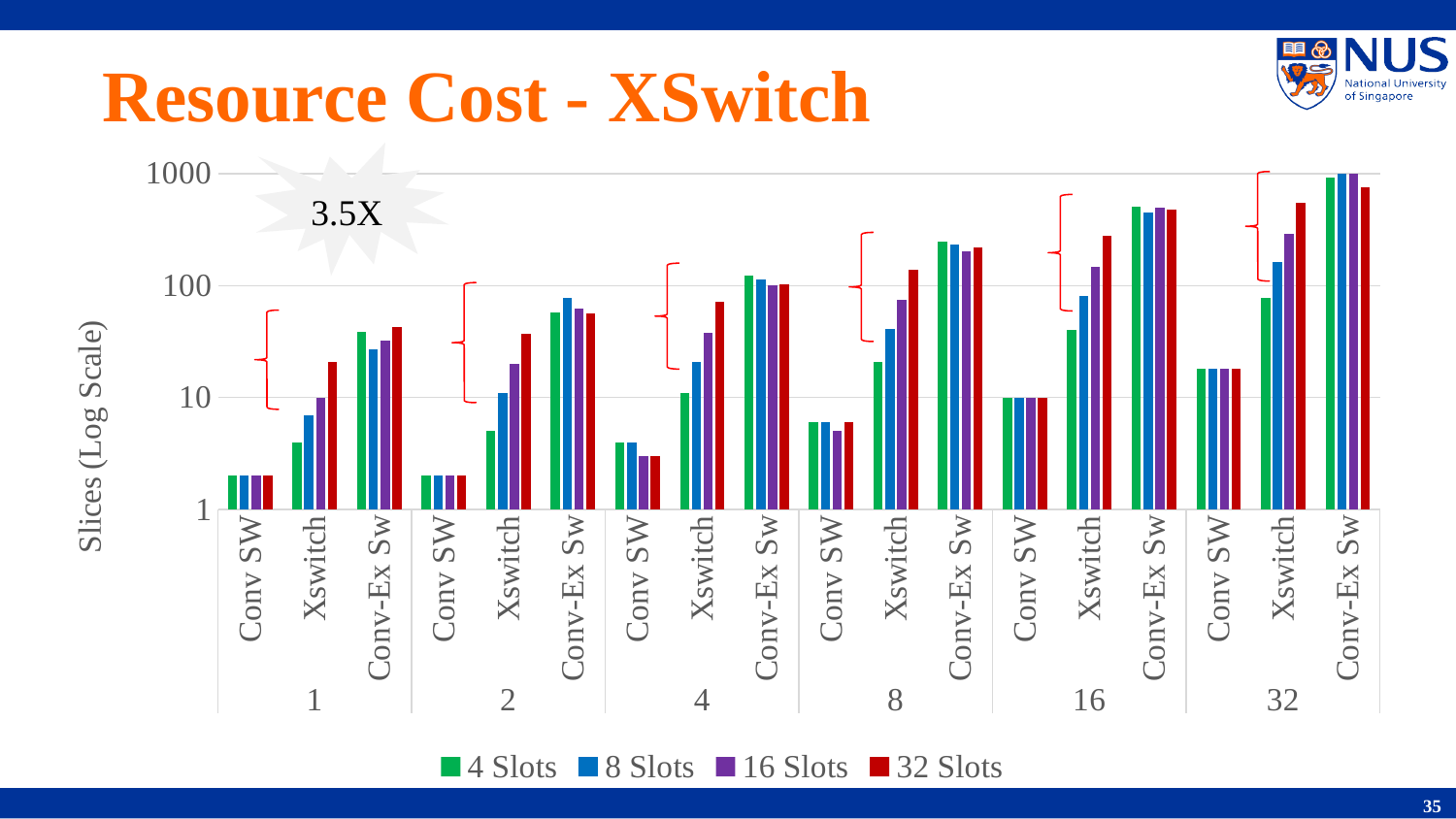
Is the 8 Slots value for Conv SW in group 32 greater or less than 10? greater What kind of chart is shown on the slide? bar chart In group 32, which is larger for 32 Slots: Xswitch or Conv SW? Xswitch What is the title of the y axis? Slices (Log Scale) How many numbered groups (1, 2, 4, 8, 16, 32) are shown along the x axis? 6 Is the 4 Slots value for Conv SW in group 1 greater or less than 10? less Is the 4 Slots value for Conv-Ex Sw in group 32 greater or less than 100? greater What are the legend entries of the chart? 4 Slots, 8 Slots, 16 Slots, 32 Slots In group 4, which configuration has the highest 4 Slots bar? Conv-Ex Sw For the 4 Slots series of Conv SW, do the values rise or fall as the group number increases from 1 to 32? rise How many series does the legend list? 4